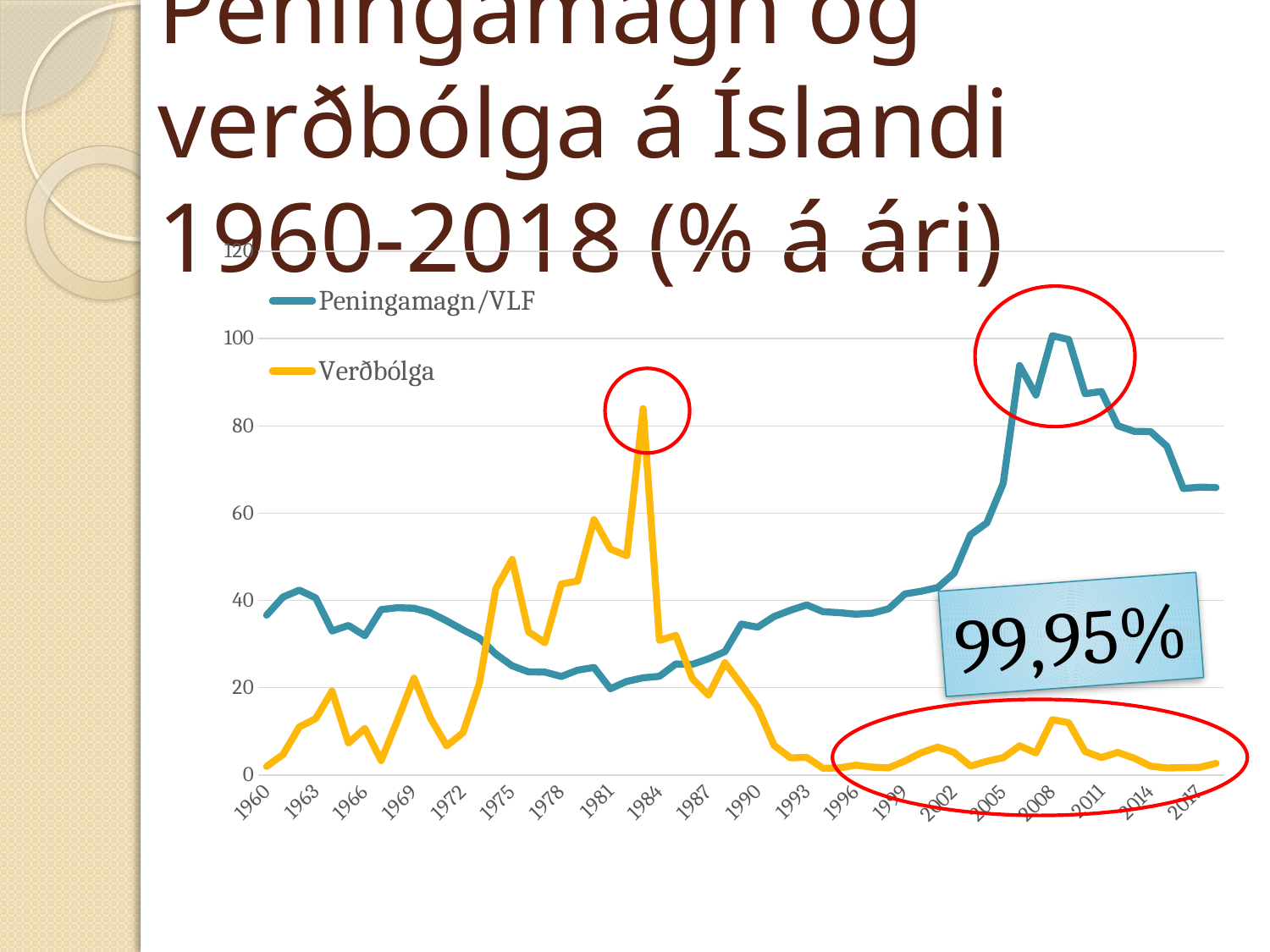
How many series does the legend list? 2 Which series reaches the highest value anywhere on the chart? Peningamagn/VLF Is the highest value reached by Verðbólga greater or less than 80? greater What percentage is shown in the highlighted box on the chart? 99,95% Is the value of Peningamagn/VLF in 2017 greater or less than 60? greater Is the value of Verðbólga in 1975 greater or less than 40? greater In 2017, which series has the higher value, Peningamagn/VLF or Verðbólga? Peningamagn/VLF Does Peningamagn/VLF rise or fall between 2008 and 2017? fall What kind of chart is shown on the slide? line chart What are the two series named in the legend? Peningamagn/VLF and Verðbólga